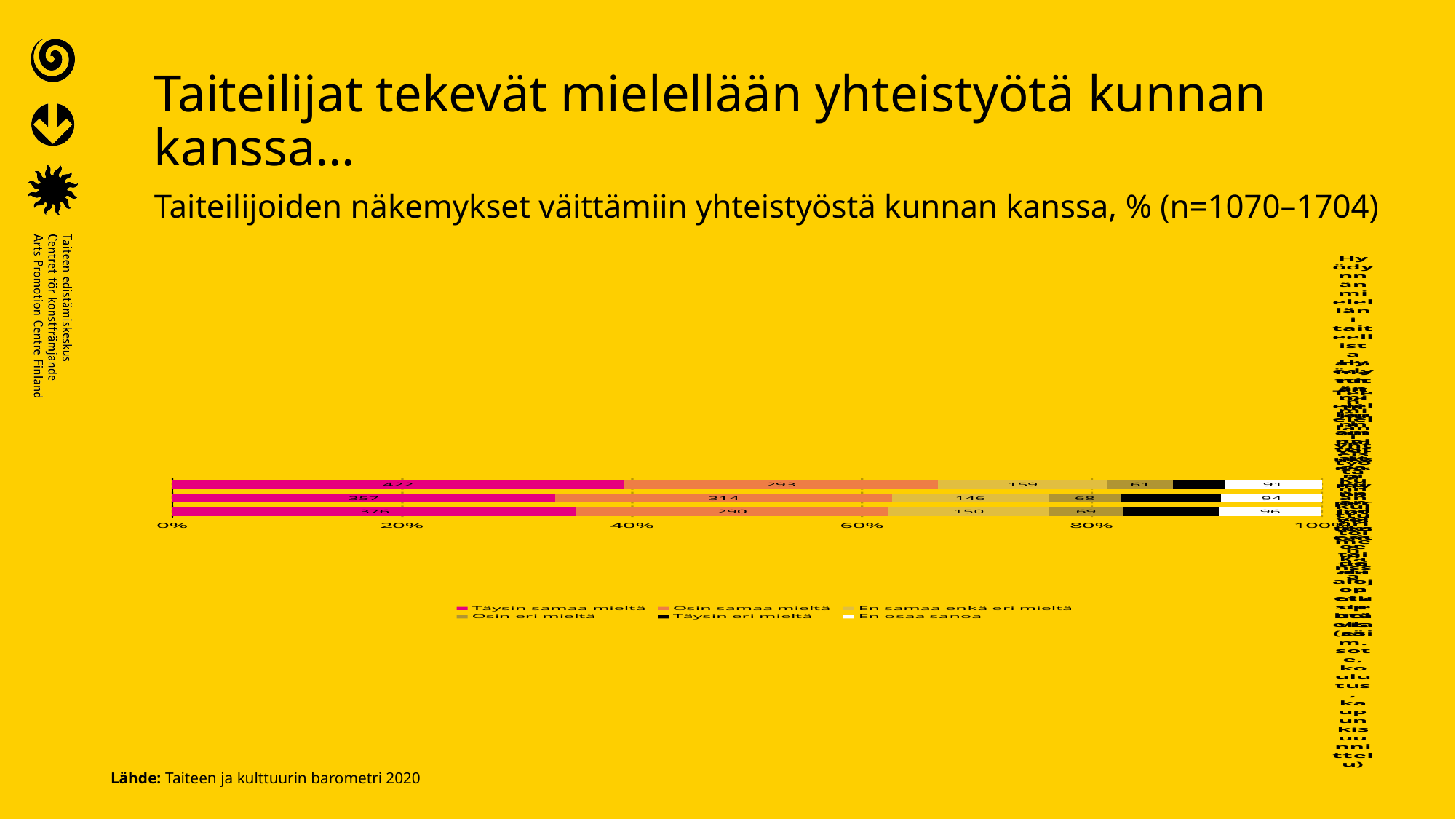
What kind of chart is shown on the slide? Stacked horizontal bar chart What is the value of the 'Täysin samaa mieltä' segment in the top bar? 422 What is the value of the 'Osin samaa mieltä' segment in the middle bar? 314 How many series does the legend list? 6 What is the value of the 'En osaa sanoa' segment in the bottom bar? 96 Which bar has the highest 'Täysin samaa mieltä' value? The top bar Is the 'Täysin samaa mieltä' segment of the middle bar greater or less than 40% of the bar? less Which is larger: the 'Osin samaa mieltä' value of the middle bar or of the top bar? The middle bar What is the difference between the 'Täysin samaa mieltä' values of the top bar and the bottom bar? 46 What is the value of the 'En samaa enkä eri mieltä' segment in the bottom bar? 150 Which bar has the lowest 'Osin eri mieltä' value? The top bar How many bars are plotted in the chart? 3